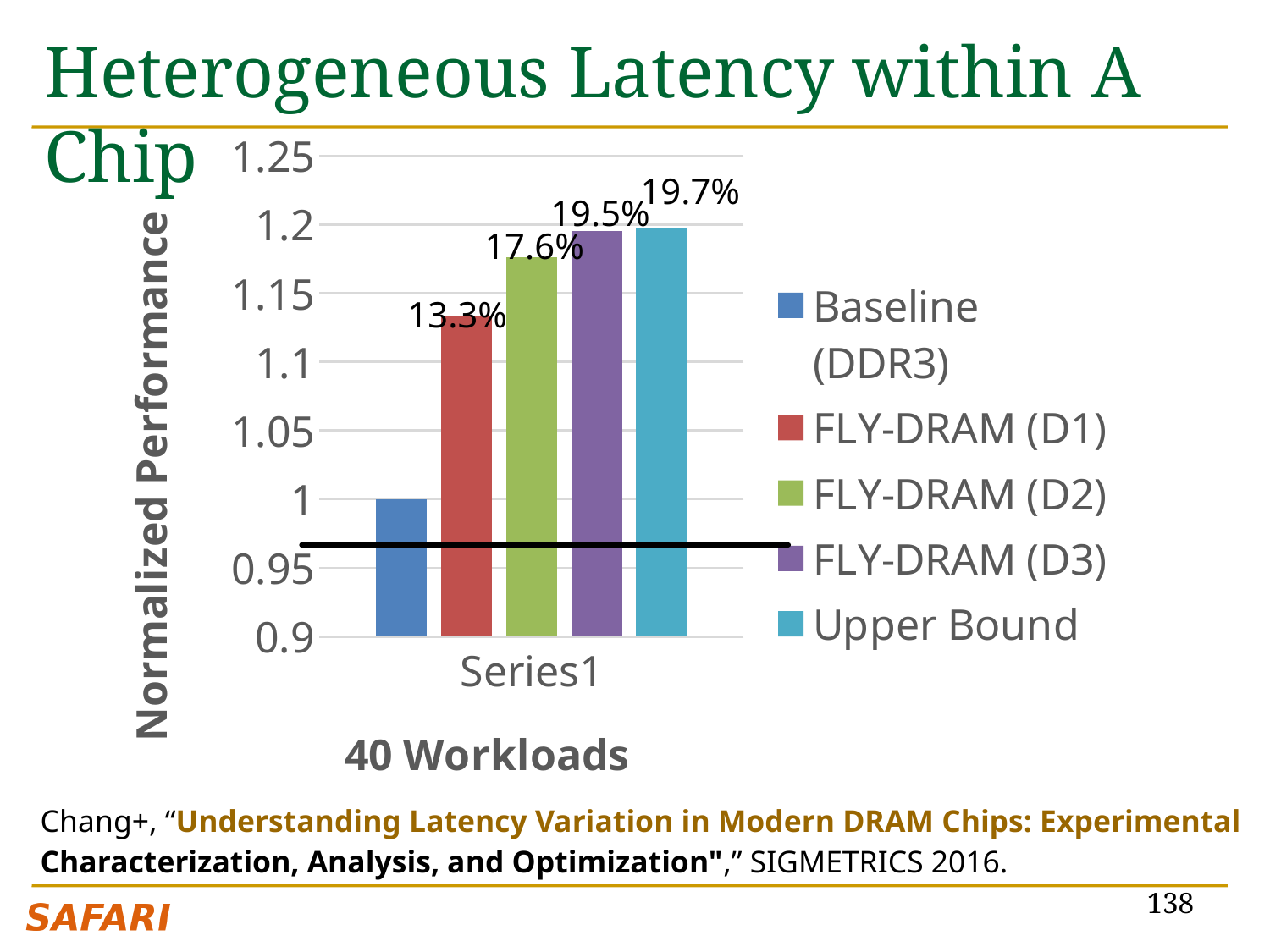
Is the bar for FLY-DRAM (D1) greater or less than 1.1? greater Which series has the highest labeled improvement in the chart? Upper Bound What data label is shown on the FLY-DRAM (D2) bar? 17.6% What normalized performance value does the Baseline (DDR3) bar reach? 1 How many series does the legend list? 5 What data label is shown on the FLY-DRAM (D3) bar? 19.5% What is the title of the vertical axis? Normalized Performance What data label is shown on the Upper Bound bar? 19.7% Which bar is taller, FLY-DRAM (D1) or FLY-DRAM (D3)? FLY-DRAM (D3) Is the bar for FLY-DRAM (D2) greater or less than 1.15? greater Which series has the lowest bar in the chart? Baseline (DDR3) What data label is shown on the FLY-DRAM (D1) bar? 13.3%